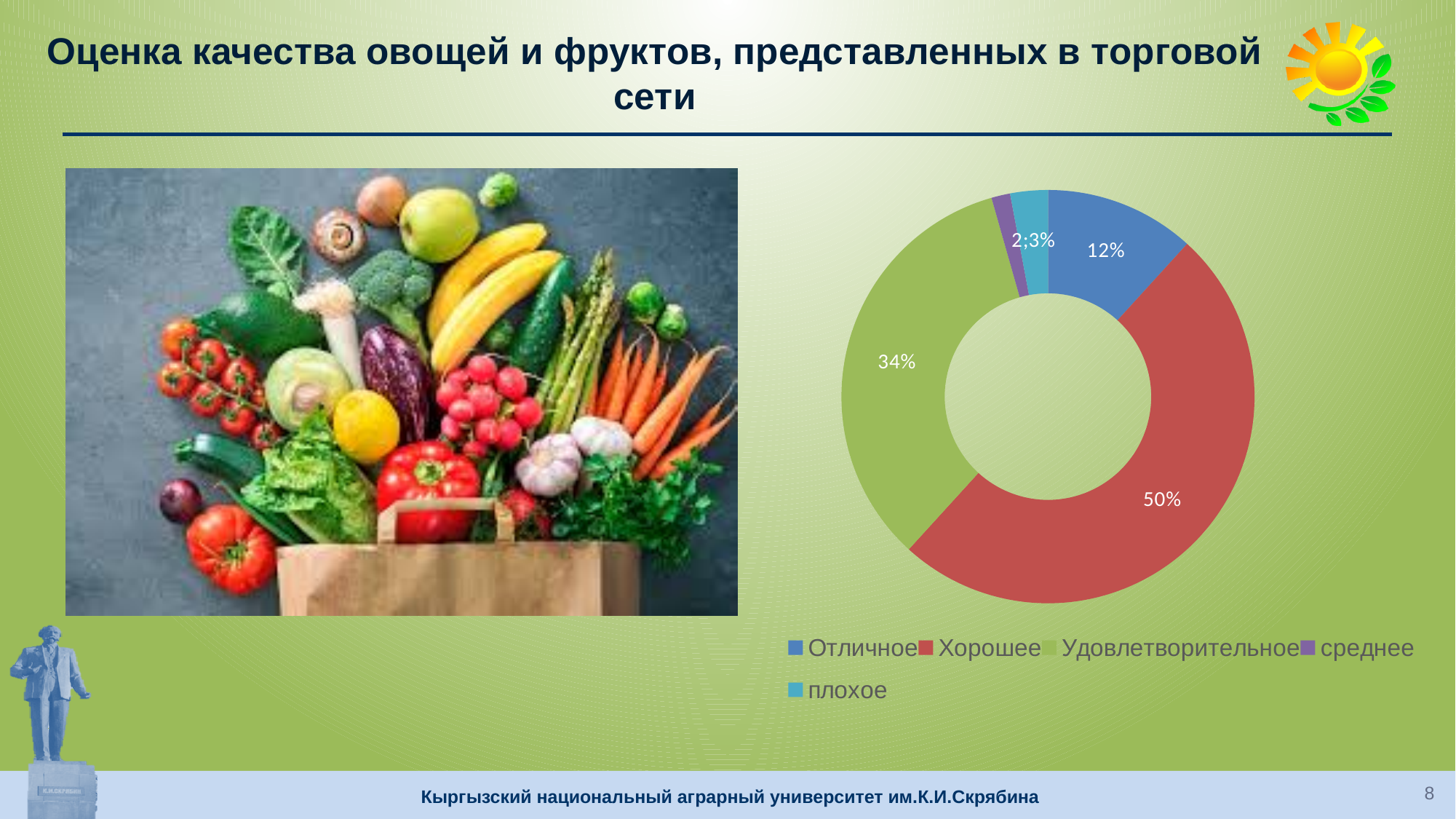
What percentage is shown for the "Хорошее" category? 50% What kind of chart is shown on the slide? doughnut chart What is the difference between the shares for "Удовлетворительное" and "Отличное"? 22% How many categories does the legend list? 5 What percentage is shown for the "Отличное" category? 12% What colour represents the "Хорошее" category in the chart? red Which is larger, the share for "Хорошее" or for "Отличное"? Хорошее Which is larger, the share for "Отличное" or for "Удовлетворительное"? Удовлетворительное What is the combined share of "Отличное", "Хорошее" and "Удовлетворительное"? 96% What is the difference between the shares for "Хорошее" and "Удовлетворительное"? 16% Which category has the largest share of the chart? Хорошее What percentage is shown for the "Удовлетворительное" category? 34%